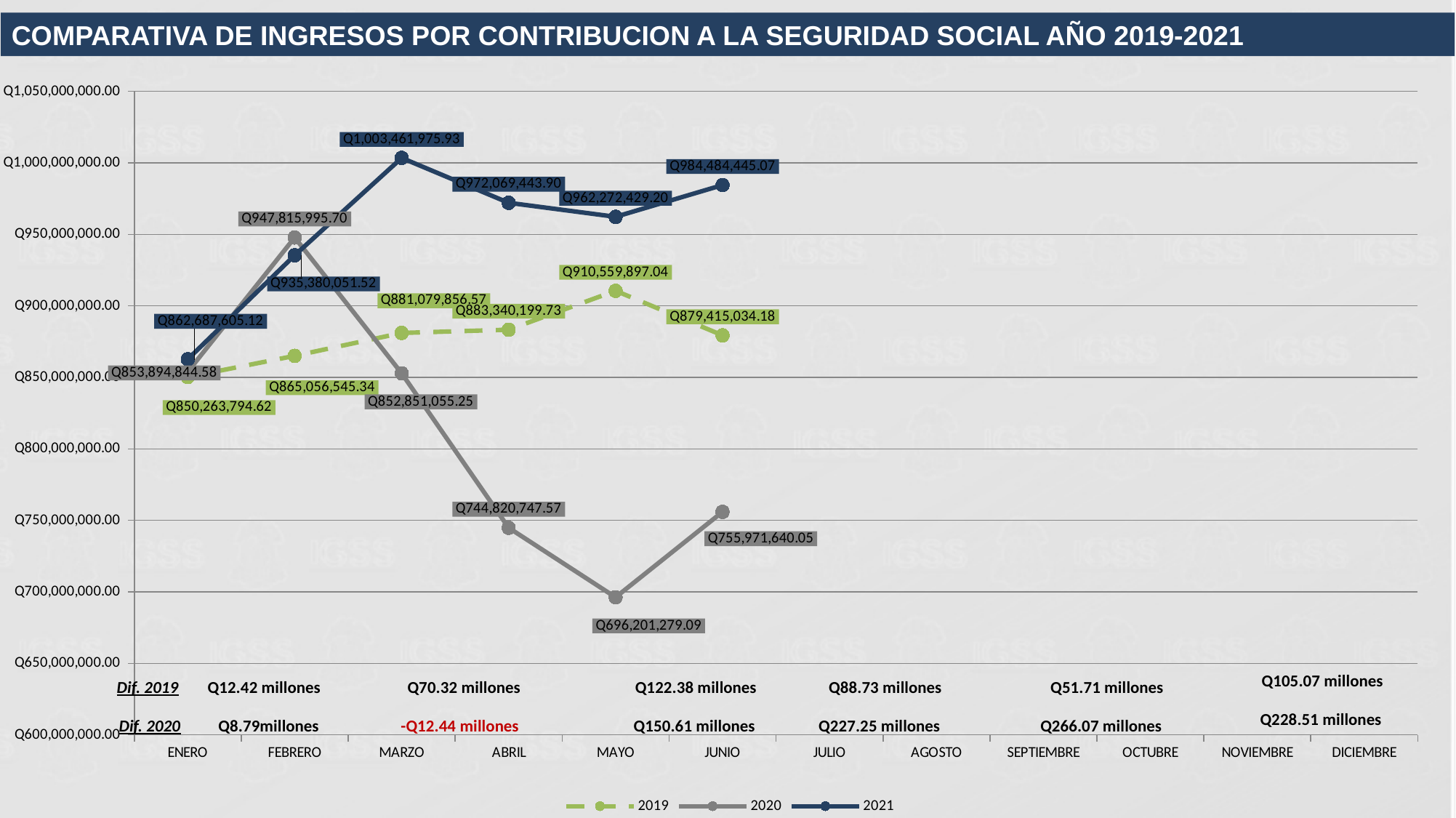
In which month does the 2019 series reach its highest value? MAYO What is the difference between the 2021 and 2019 values in JUNIO? Q105,069,410.89 What is the value for 2019 in ENERO? Q850,263,794.62 What is the value for 2020 in MAYO? Q696,201,279.09 What kind of chart is shown on the slide? Line chart How many months have plotted data points for the 2021 series? 6 Does the 2019 series rise or fall from ENERO to MAYO? Rise How many series does the legend list? 3 In FEBRERO, which series has the larger value, 2020 or 2021? 2020 In which month does the 2020 series reach its lowest value? MAYO In which month does the 2021 series reach its highest value? MARZO What is the value for 2021 in MARZO? Q1,003,461,975.93